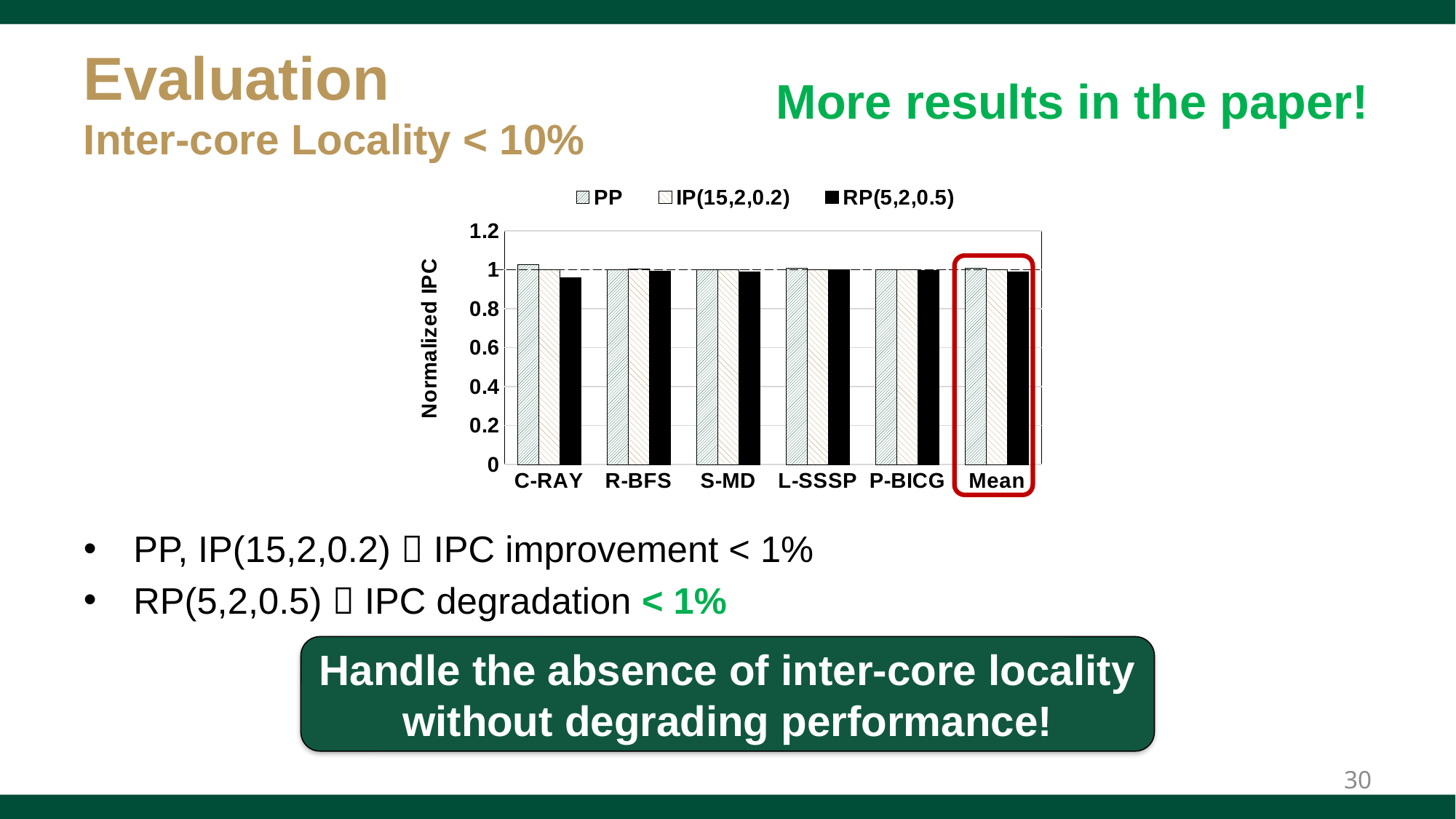
How many series does the chart's legend list? 3 Which category on the x axis is highlighted with a red box? Mean Is the RP(5,2,0.5) value for C-RAY greater or less than 0.8? greater What kind of chart is shown on the slide? bar chart How many categories are shown on the x axis of the chart? 6 What is the label of the y axis of the chart? Normalized IPC Is the IP(15,2,0.2) value for Mean greater or less than 0.6? greater Is the PP value for L-SSSP greater or less than 0.2? greater What is the highest tick value shown on the y axis of the chart? 1.2